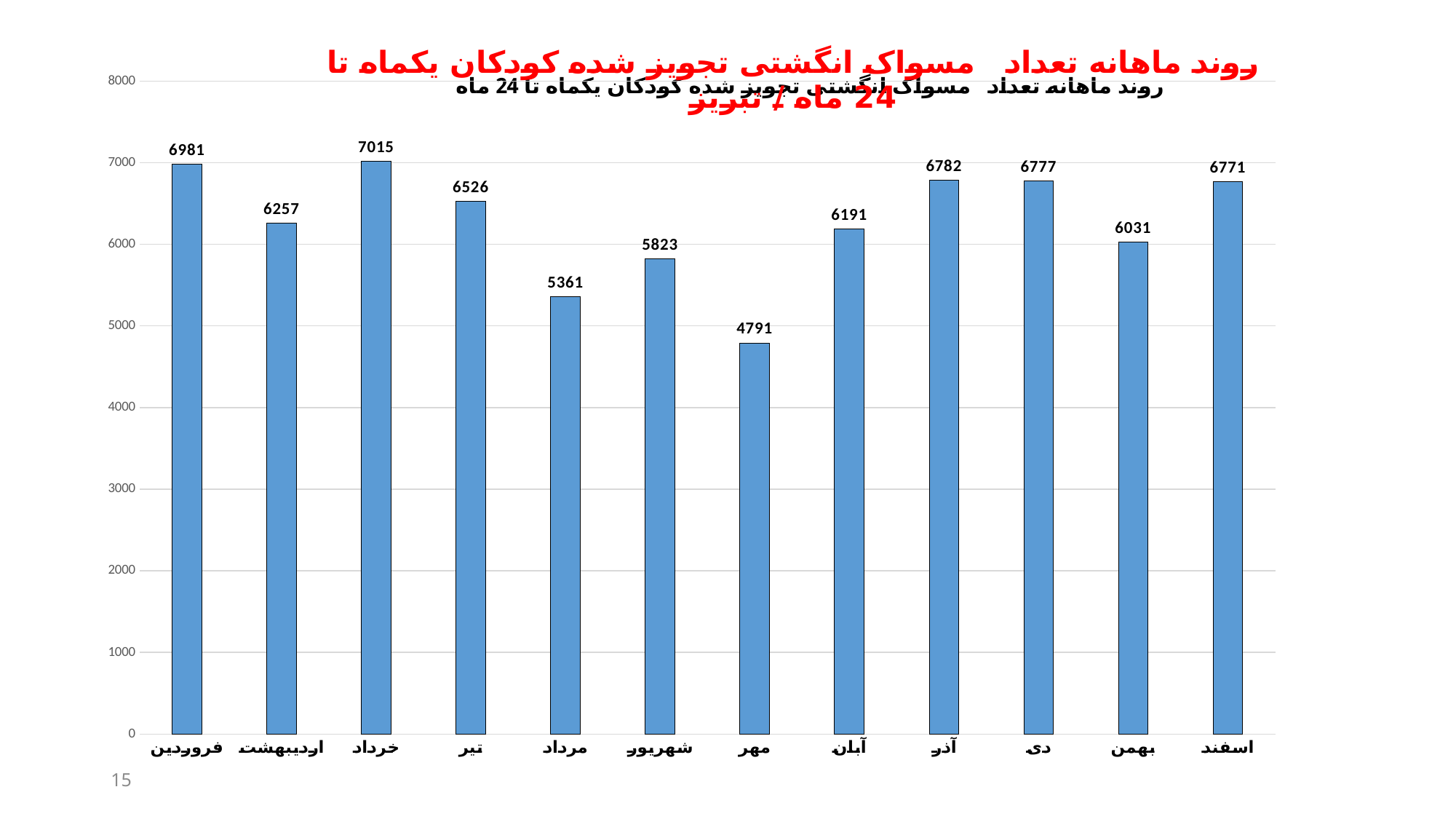
What is the difference between the values for فروردین and اردیبهشت? 724 What is the value for مهر? 4791 Which is larger, the value for مرداد or the value for شهریور? شهریور Do the values rise or fall from مهر to آذر? rise Which month has the lowest value? مهر How many months are shown on the x axis? 12 What is the value for خرداد? 7015 Which month has the highest value? خرداد Is the value for مهر greater or less than 5000? less What kind of chart is shown on the slide? bar chart What is the value for اسفند? 6771 What is the difference between the values for خرداد and مهر? 2224